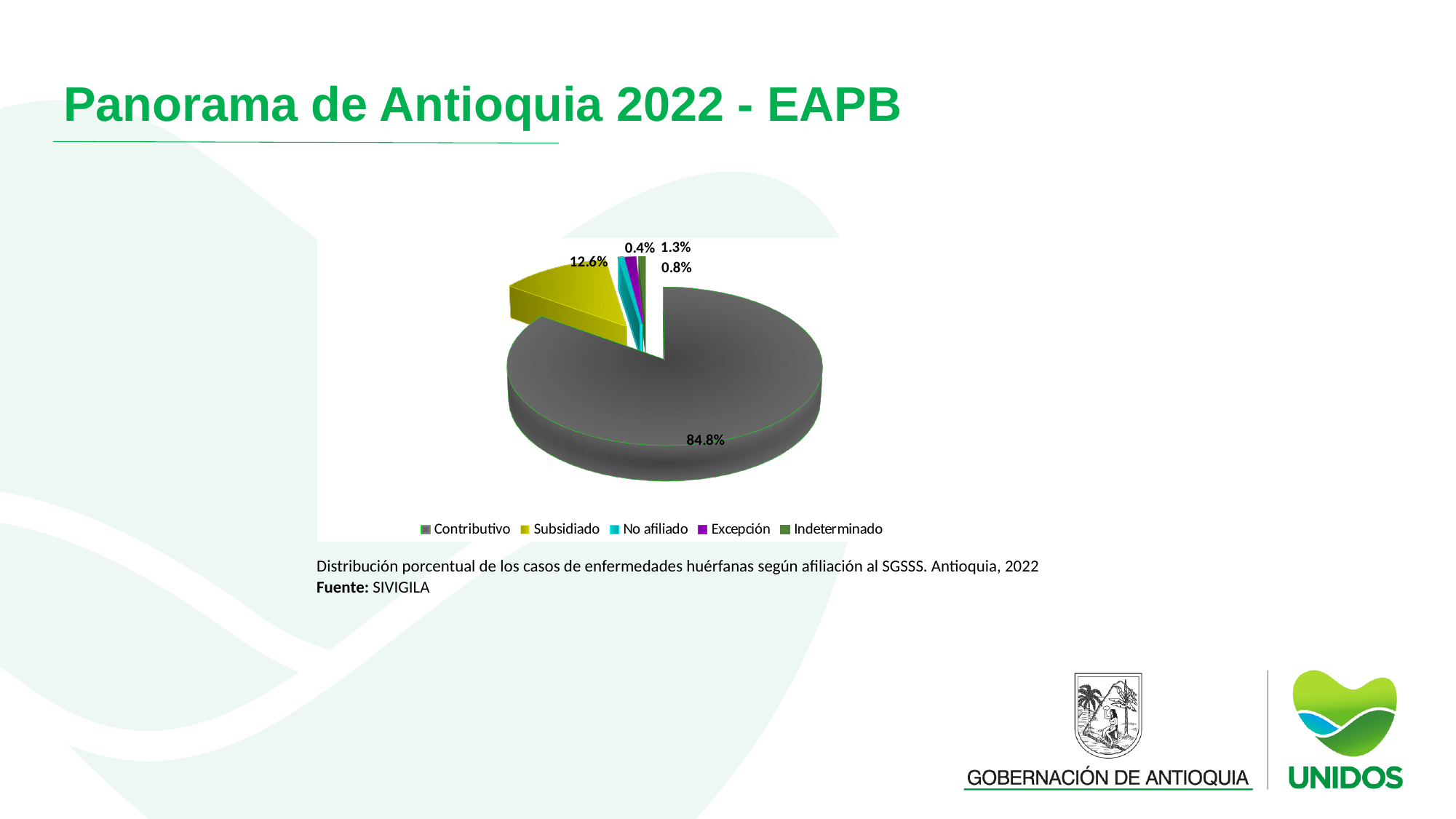
What is the title of the slide? Panorama de Antioquia 2022 - EAPB How many categories does the pie chart show? 5 What kind of chart is shown on the slide? Pie chart What percentage of the pie does Contributivo represent? 84.8% Which is larger, the share for Contributivo or the share for Subsidiado? Contributivo What is the difference in percentage points between the Contributivo and Subsidiado shares? 72.2 percentage points What percentage of the pie does Subsidiado represent? 12.6% How many entries does the legend list? 5 What is the smallest percentage value labelled on the pie chart? 0.4% Is the share for Subsidiado greater or less than 10%? greater Which affiliation category has the largest share of the pie? Contributivo What source is cited for the chart data? SIVIGILA